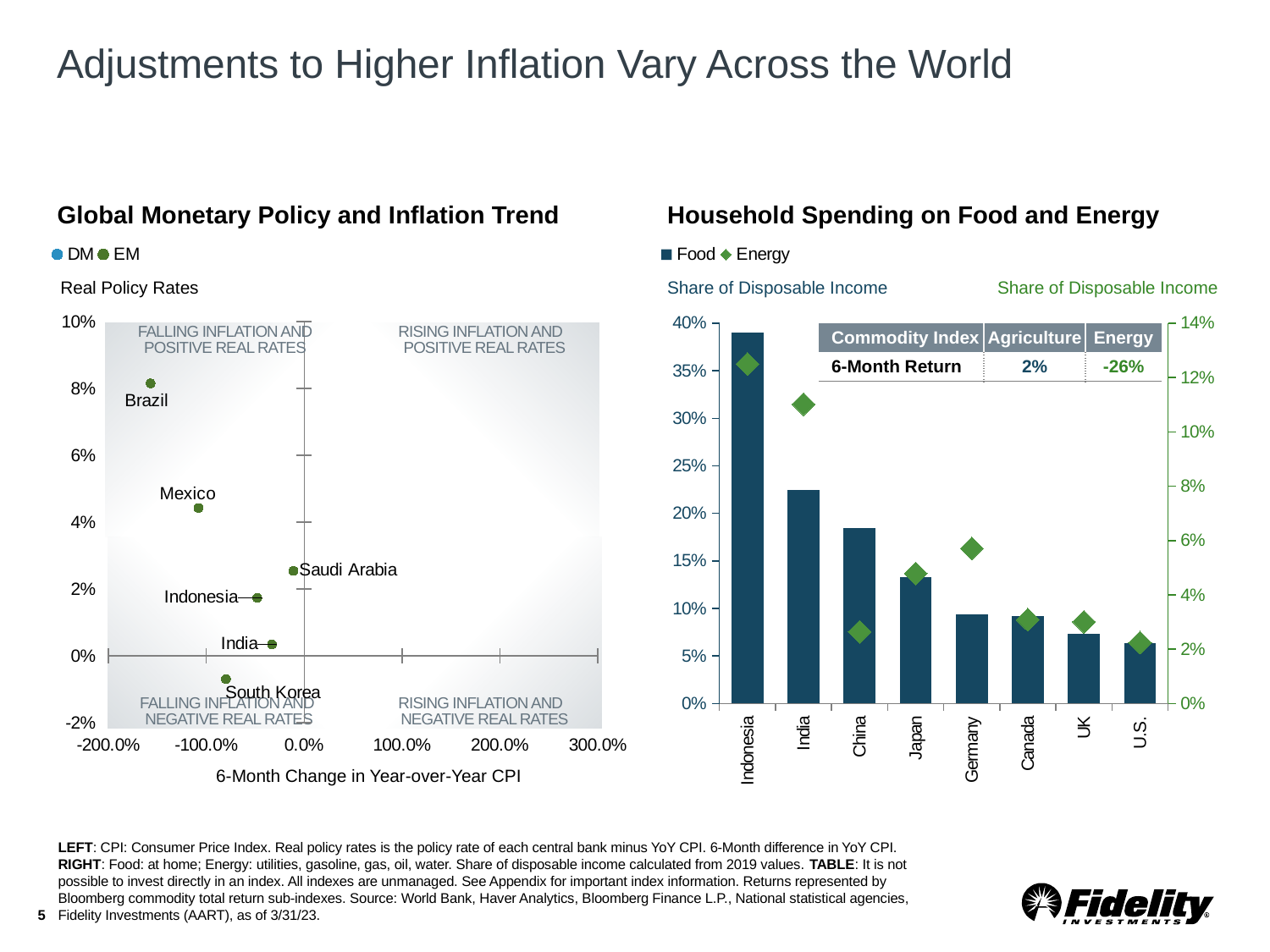
How many countries are shown on the x axis of the 'Household Spending on Food and Energy' chart? 8 How many series does the legend of the 'Global Monetary Policy and Inflation Trend' chart list? 2 In the table on the 'Household Spending on Food and Energy' chart, what is the 6-Month Return for the Energy commodity index? -26% In the 'Global Monetary Policy and Inflation Trend' chart, which country has the lowest real policy rate? South Korea In the 'Household Spending on Food and Energy' chart, which country has the highest Food share of disposable income? Indonesia In the 'Household Spending on Food and Energy' chart, do the Food bars rise or fall from left to right across the countries? Fall In the 'Household Spending on Food and Energy' chart, is the Food share for India greater or less than 25%? less In the 'Household Spending on Food and Energy' chart, which country has a larger Food share of disposable income, India or China? India What kind of chart is the 'Household Spending on Food and Energy' chart on the right? Bar chart In the 'Household Spending on Food and Energy' chart, which country has the lowest Food share of disposable income? U.S. In the 'Global Monetary Policy and Inflation Trend' chart, which country has the highest real policy rate? Brazil In the 'Household Spending on Food and Energy' chart, is the Food share for Indonesia greater or less than 35%? greater